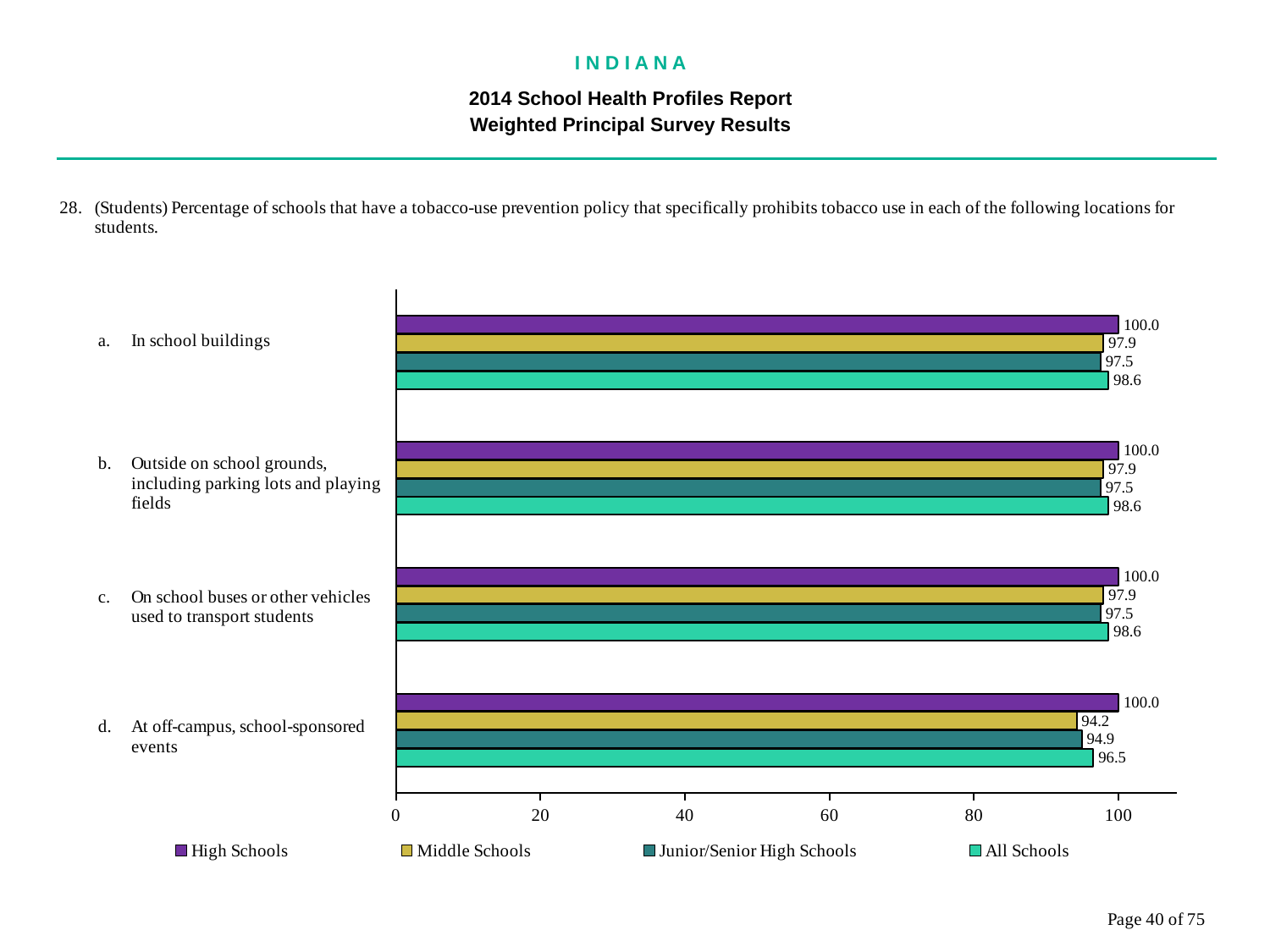
What is the value for Middle Schools for 'At off-campus, school-sponsored events'? 94.2 What is the value for Junior/Senior High Schools for 'On school buses or other vehicles used to transport students'? 97.5 How many location categories are shown on the chart? 4 How many series does the legend list? 4 What is the difference between the All Schools value and the Middle Schools value for 'At off-campus, school-sponsored events'? 2.3 Which series is shown in purple in the legend? High Schools Which series has the lowest value for 'At off-campus, school-sponsored events'? Middle Schools What is the value for All Schools for 'In school buildings'? 98.6 What kind of chart is shown on the slide? bar chart Which is larger for 'At off-campus, school-sponsored events': the Junior/Senior High Schools value or the Middle Schools value? Junior/Senior High Schools What is the value for High Schools for 'Outside on school grounds, including parking lots and playing fields'? 100.0 Is the value for Middle Schools for 'In school buildings' greater or less than 80? greater